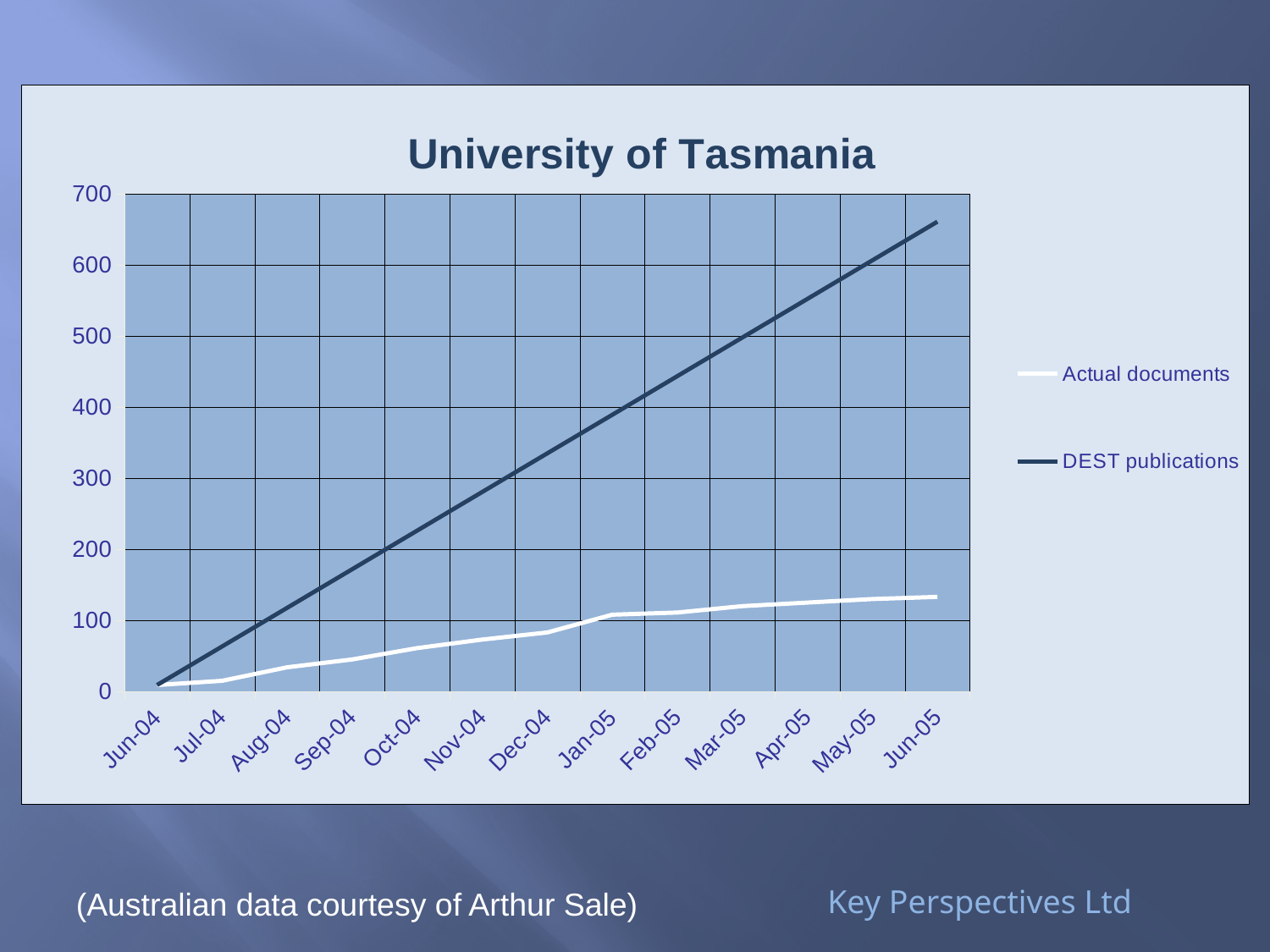
Is the value for Actual documents in Nov-04 greater or less than 100? less What is the title of the chart? University of Tasmania Which series has the higher value in Jun-05, Actual documents or DEST publications? DEST publications How many months are shown along the x axis? 13 Which series is drawn with the white line? Actual documents Is the value for Actual documents in Jun-05 greater or less than 200? less Is the value for DEST publications in Mar-05 greater or less than 400? greater Do the Actual documents values rise or fall from Jun-04 to Jun-05? rise What kind of chart is shown on the slide? line chart How many series does the legend list? 2 Do the DEST publications values rise or fall from Jun-04 to Jun-05? rise